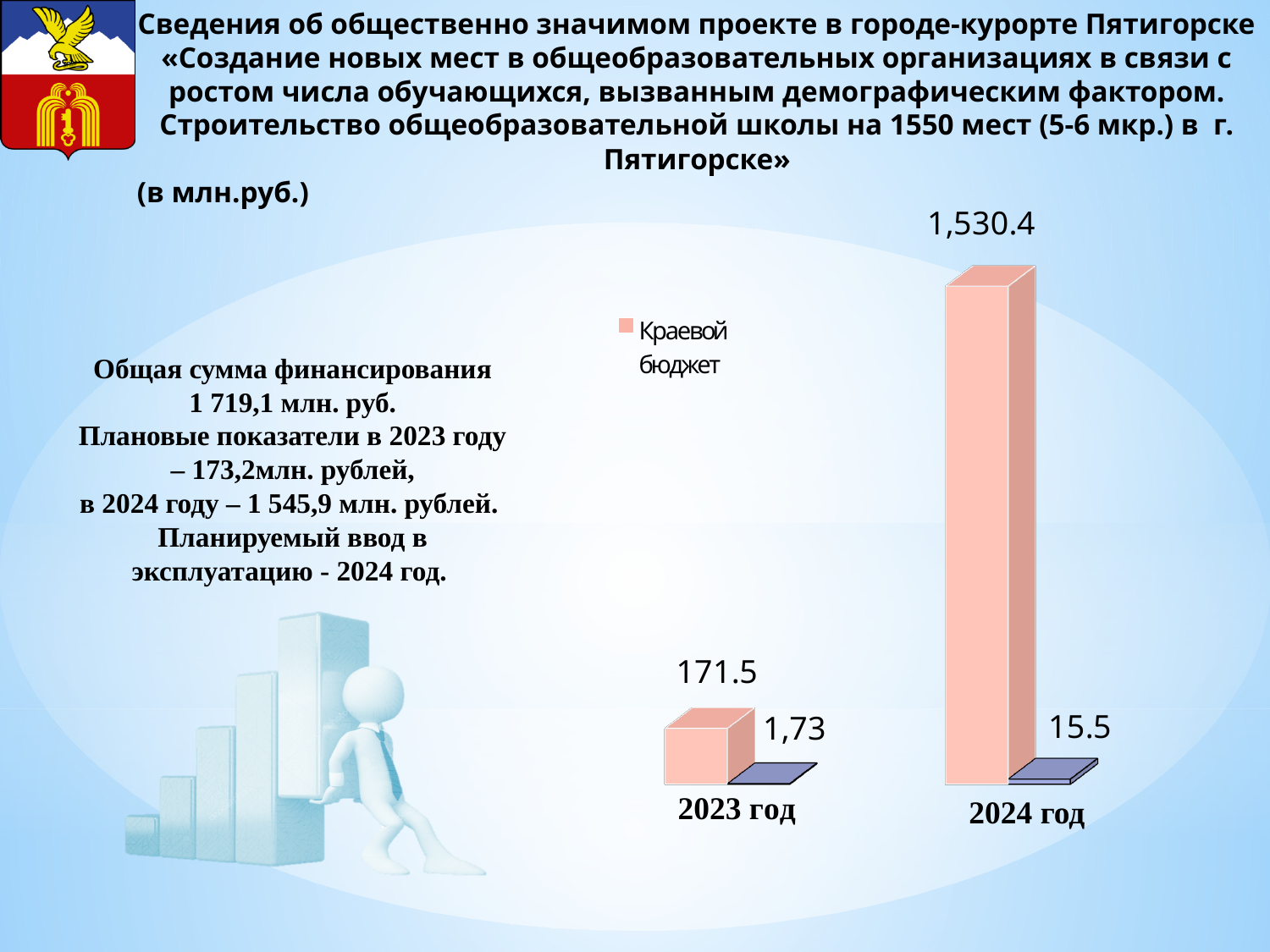
How many year categories are shown on the x axis of the chart? 2 How many series does the chart legend list? 1 What kind of chart is shown on the slide? Bar chart What value is labelled on the small blue bar for 2024 год? 15.5 What is the value of Краевой бюджет for 2024 год? 1,530.4 Which year has the lowest value for Краевой бюджет? 2023 год Does the Краевой бюджет value rise or fall from 2023 год to 2024 год? Rises Which year has the highest value for Краевой бюджет? 2024 год What is the difference between the Краевой бюджет values for 2024 год and 2023 год? 1,358.9 What is the value of Краевой бюджет for 2023 год? 171.5 Which is larger, the Краевой бюджет value for 2023 год or for 2024 год? 2024 год What value is labelled on the small blue bar for 2023 год? 1,73